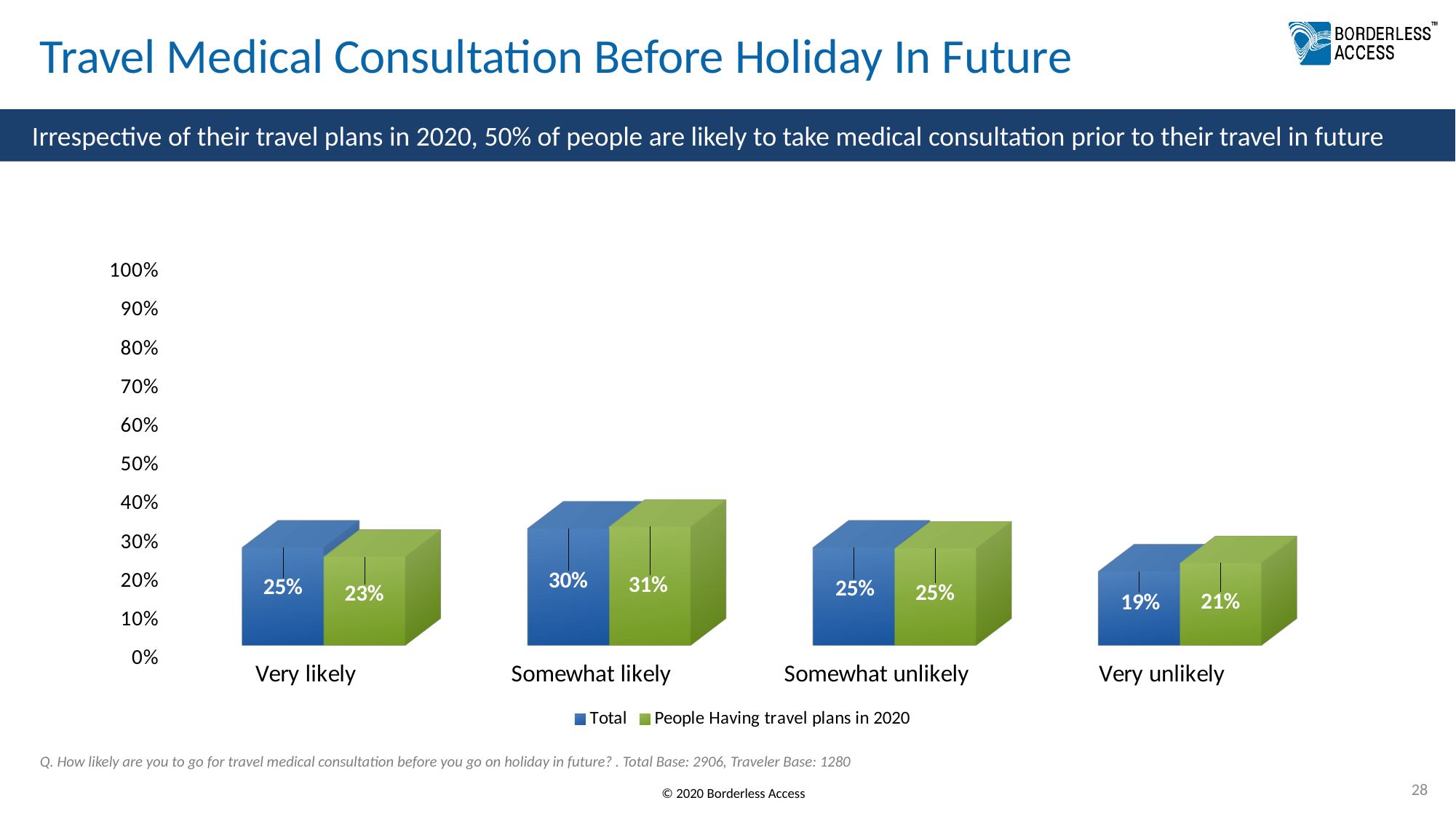
What is the value for People Having travel plans in 2020 in the Somewhat likely category? 31% What colour represents the Total series in the chart? blue What kind of chart is shown on the slide? bar chart Which category has the lowest value for the People Having travel plans in 2020 series? Very unlikely How many series does the legend list? 2 Is the Total value for Somewhat likely greater or less than 50%? less What is the difference between the Total and People Having travel plans in 2020 values in the Very likely category? 2% What is the value for Total in the Very unlikely category? 19% In the Very unlikely category, which series has the larger value: Total or People Having travel plans in 2020? People Having travel plans in 2020 Which category has the highest value for the Total series? Somewhat likely What is the value for Total in the Very likely category? 25% How many categories are shown on the x axis? 4